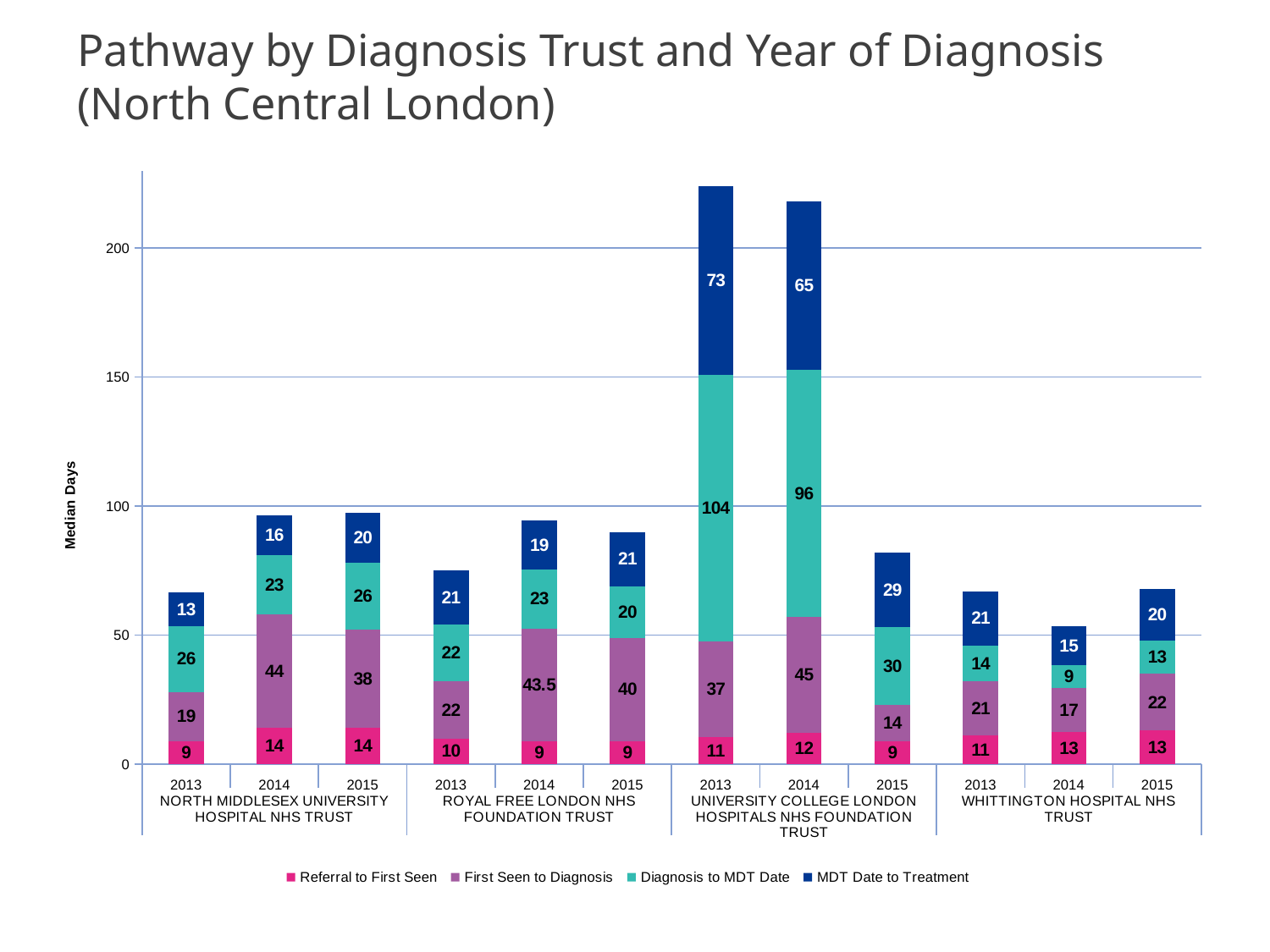
What is the MDT Date to Treatment value for Whittington Hospital NHS Trust in 2015? 20 How many series does the legend list? 4 Which bar has the lowest total median days? Whittington Hospital NHS Trust, 2014 Which is larger: the First Seen to Diagnosis value for North Middlesex University Hospital NHS Trust in 2014 or in 2015? 2014 What type of chart is shown on the slide? Stacked bar chart What is the total median days for the North Middlesex University Hospital NHS Trust 2013 bar? 67 What is the difference between the MDT Date to Treatment values for University College London Hospitals NHS Foundation Trust in 2013 and 2014? 8 What is the label on the vertical axis? Median Days What is the First Seen to Diagnosis value for Royal Free London NHS Foundation Trust in 2014? 43.5 Which bar has the highest total median days? University College London Hospitals NHS Foundation Trust, 2013 How many bars are plotted in the chart? 12 What is the Diagnosis to MDT Date value for University College London Hospitals NHS Foundation Trust in 2013? 104